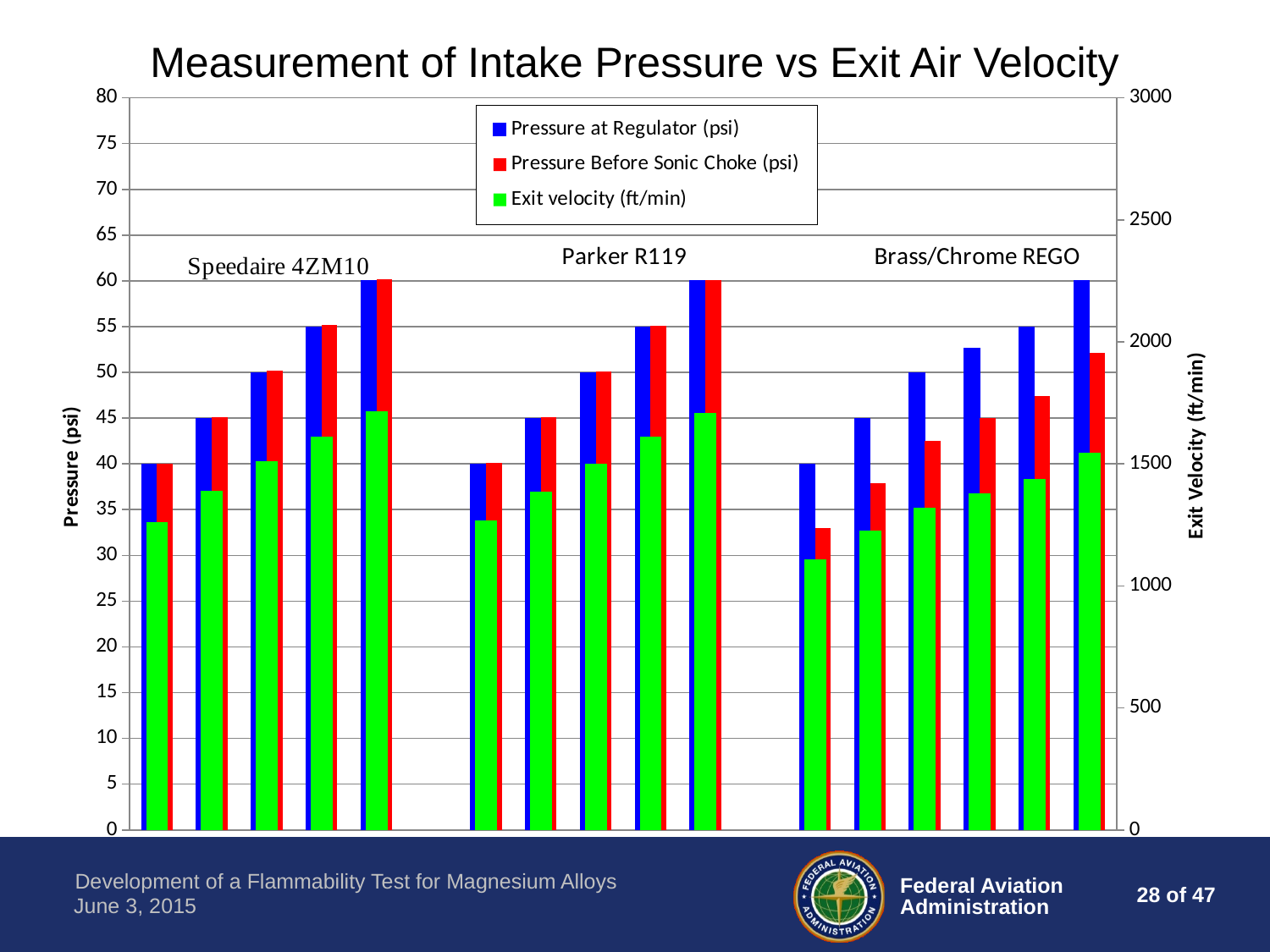
How many series does the legend list? 3 Is the Exit velocity for the first cluster of the Brass/Chrome REGO group greater or less than 1500 ft/min? less How many groups of bars (clusters) are plotted in total across the three regulators? 16 In the last cluster of the Brass/Chrome REGO group, which is larger: Pressure at Regulator or Pressure Before Sonic Choke? Pressure at Regulator What kind of chart is shown on the slide? bar chart Within the Brass/Chrome REGO group, do the Pressure at Regulator values rise or fall from left to right? rise What is the Pressure at Regulator (psi) for the last cluster of the Parker R119 group? 60 Which series is plotted in green? Exit velocity (ft/min) Is the Pressure Before Sonic Choke for the first cluster of the Brass/Chrome REGO group greater or less than 35 psi? less What is the Pressure at Regulator (psi) for the first cluster of the Speedaire 4ZM10 group? 40 Is the Exit velocity for the last cluster of the Speedaire 4ZM10 group greater or less than 1500 ft/min? greater What is the label of the right-hand vertical axis? Exit Velocity (ft/min)